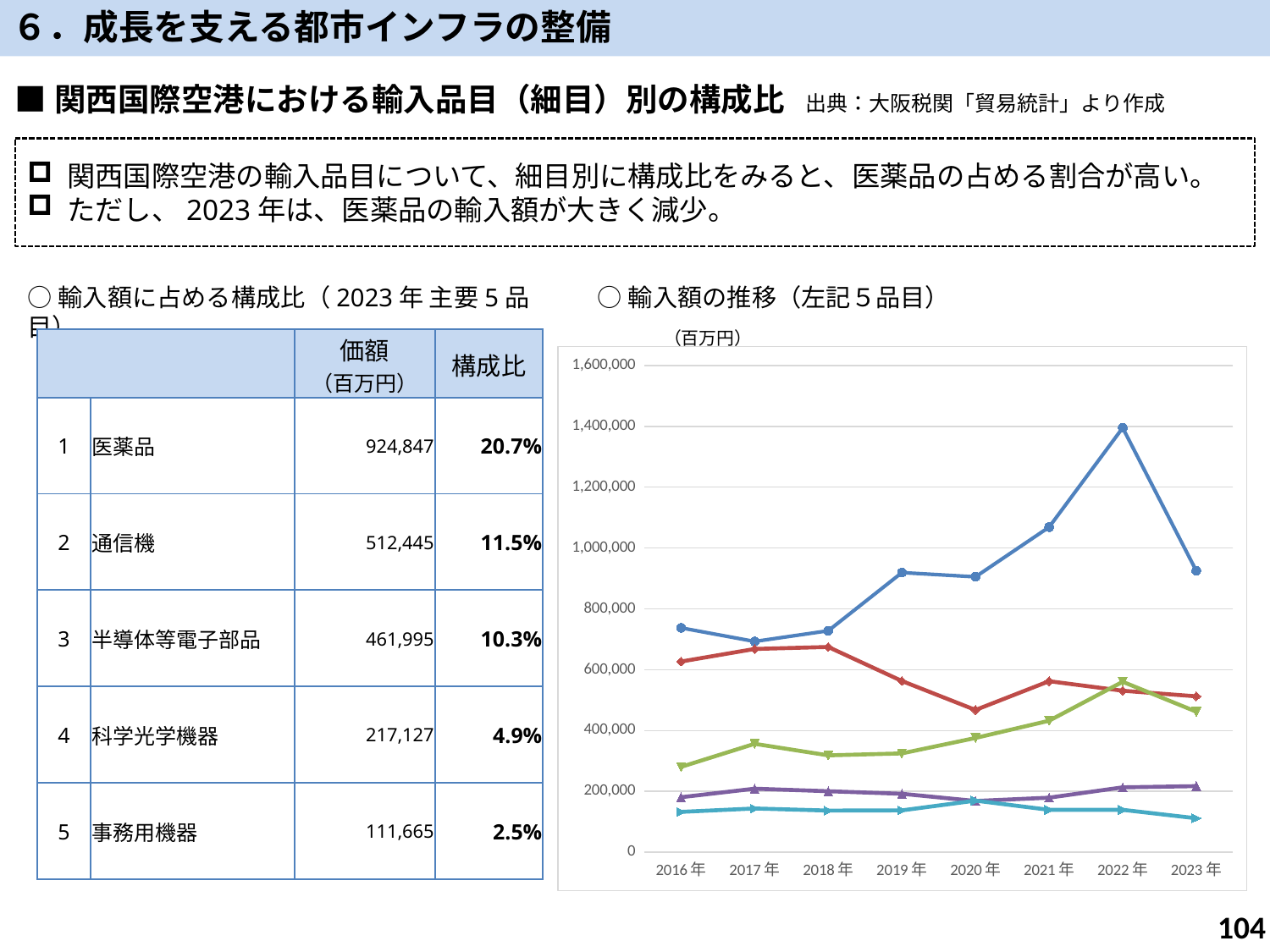
What unit is shown above the y axis of the 輸入額の推移 chart? 百万円 How many years are plotted along the x axis of the 輸入額の推移 chart? 8 In the 輸入額の推移 chart, which line is higher in 2023年, the blue line or the red line? the blue line In the 輸入額の推移 chart, does the blue line rise or fall from 2022年 to 2023年? fall In the 輸入額の推移 chart, is the value of the blue line in 2023年 greater or less than 1,000,000? less What is the first year shown on the x axis of the 輸入額の推移 chart? 2016年 How many lines are plotted in the 輸入額の推移 chart? 5 In the 輸入額の推移 chart, is the value of the blue line in 2022年 greater or less than 1,200,000? greater In the 輸入額の推移 chart, in which year does the blue line reach its highest value? 2022年 What kind of chart is shown on the right side of the slide (輸入額の推移)? line chart In the 輸入額の推移 chart, is the value of the red line in 2020年 greater or less than 600,000? less